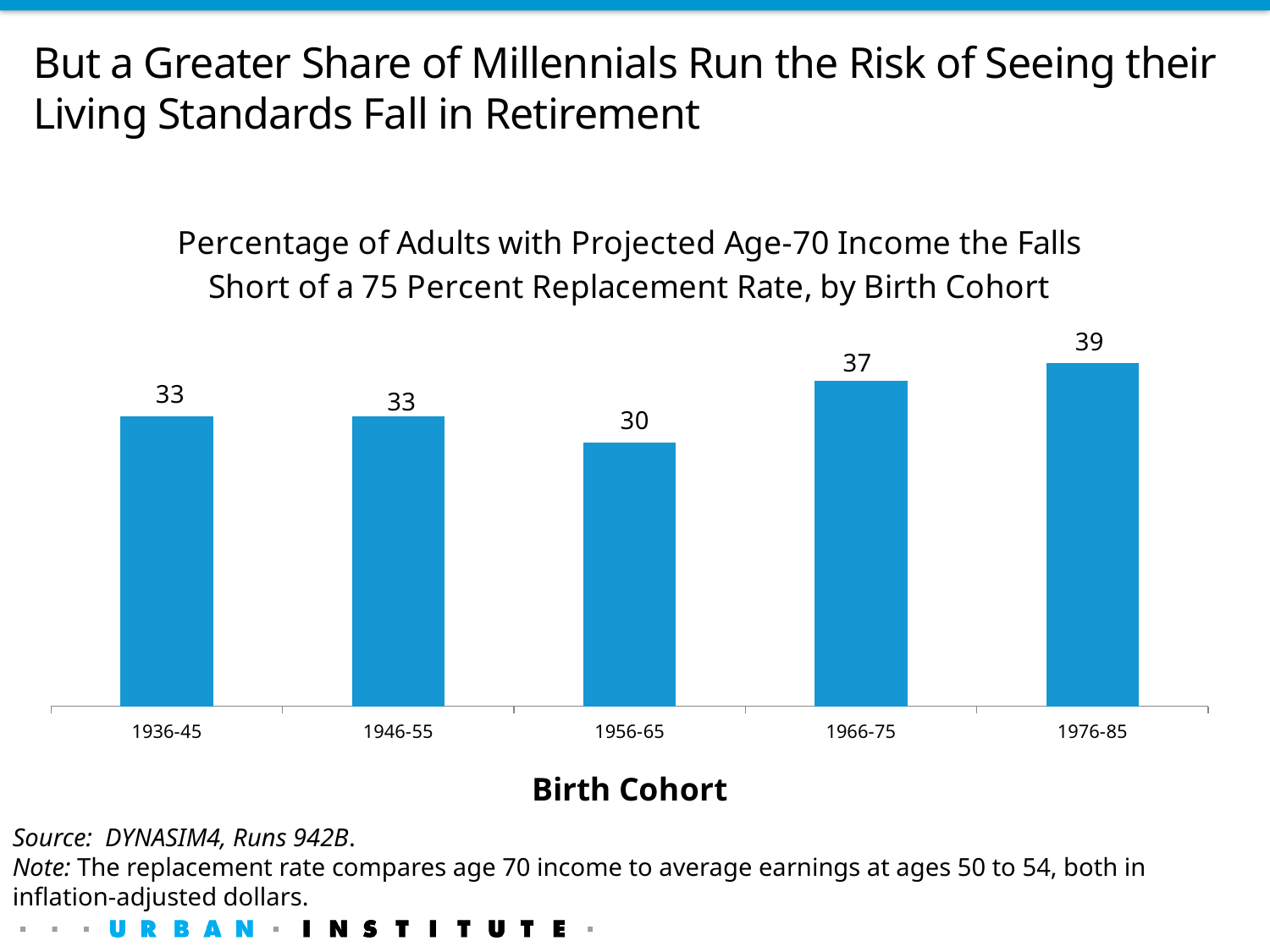
Which is larger, the value for 1966-75 or the value for 1936-45? 1966-75 What is the value for the 1966-75 birth cohort? 37 What is the value for the 1976-85 birth cohort? 39 Which birth cohort has the lowest value? 1956-65 What is the difference between the values for the 1966-75 and 1946-55 cohorts? 4 What kind of chart is shown on the slide? Bar chart Do the values for the 1936-45 and 1946-55 cohorts differ? No, both are 33 How many birth cohorts are shown on the chart? 5 What is the label of the x axis? Birth Cohort Which birth cohort has the highest value? 1976-85 What is the difference between the values for the 1976-85 and 1956-65 cohorts? 9 What is the value for the 1956-65 birth cohort? 30